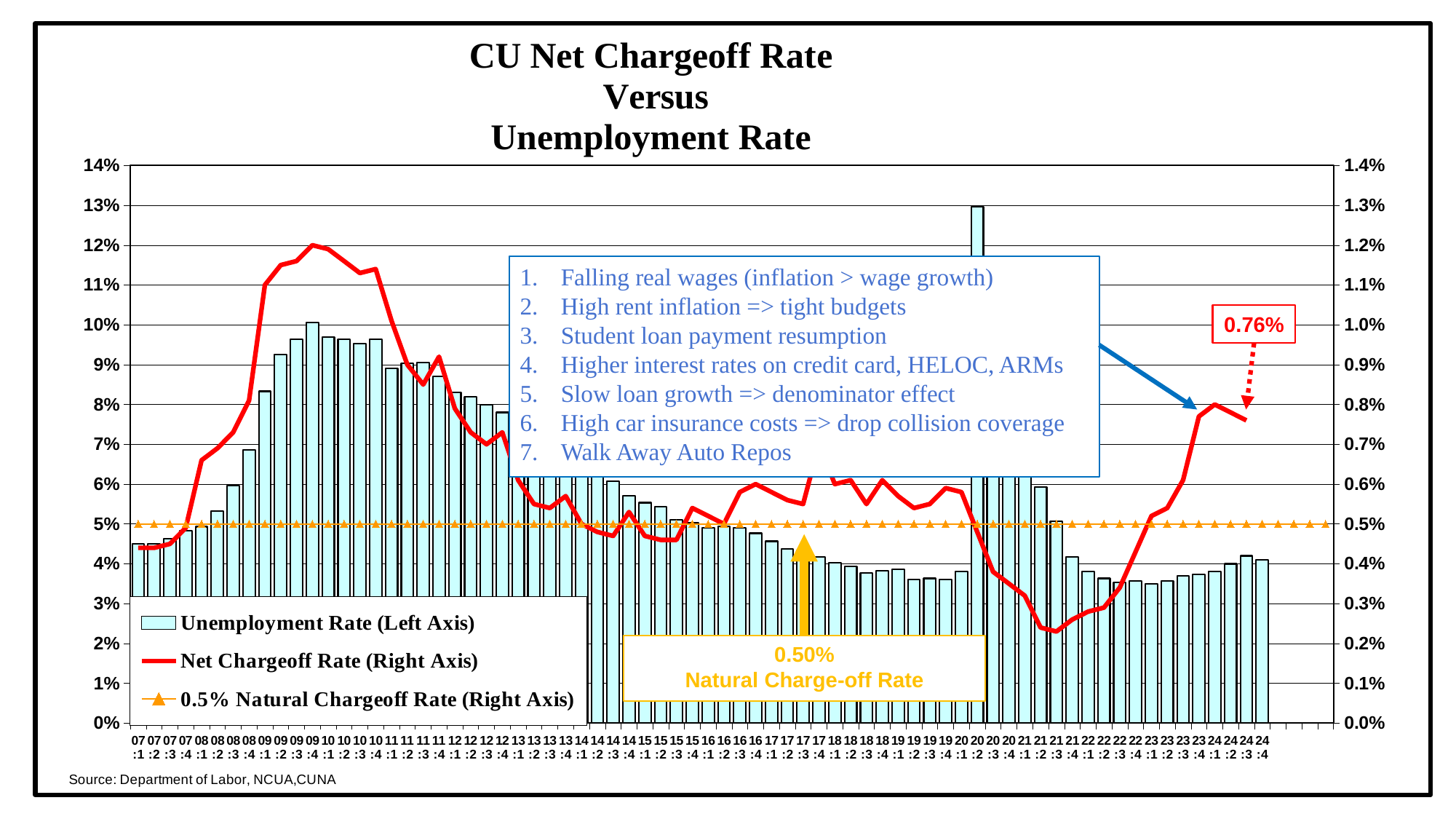
What kind of chart is this? Combined bar and line chart Is the Net Chargeoff Rate at its peak around 09:4 greater or less than 1.1%? greater Which quarter has the highest Unemployment Rate bar? 20:2 Which is larger, the most recent Net Chargeoff Rate or the 0.5% Natural Chargeoff Rate? Net Chargeoff Rate What is the title of the chart? CU Net Chargeoff Rate Versus Unemployment Rate Is the Unemployment Rate for 07:1 greater or less than 5%? less What value is annotated for the most recent Net Chargeoff Rate point? 0.76% Is the Net Chargeoff Rate at its low point around 21:3 greater or less than 0.3%? less How many series does the legend list? 3 What is the Natural Charge-off Rate shown on the chart? 0.50% Does the Net Chargeoff Rate rise or fall from 21:3 to 23:4? rise